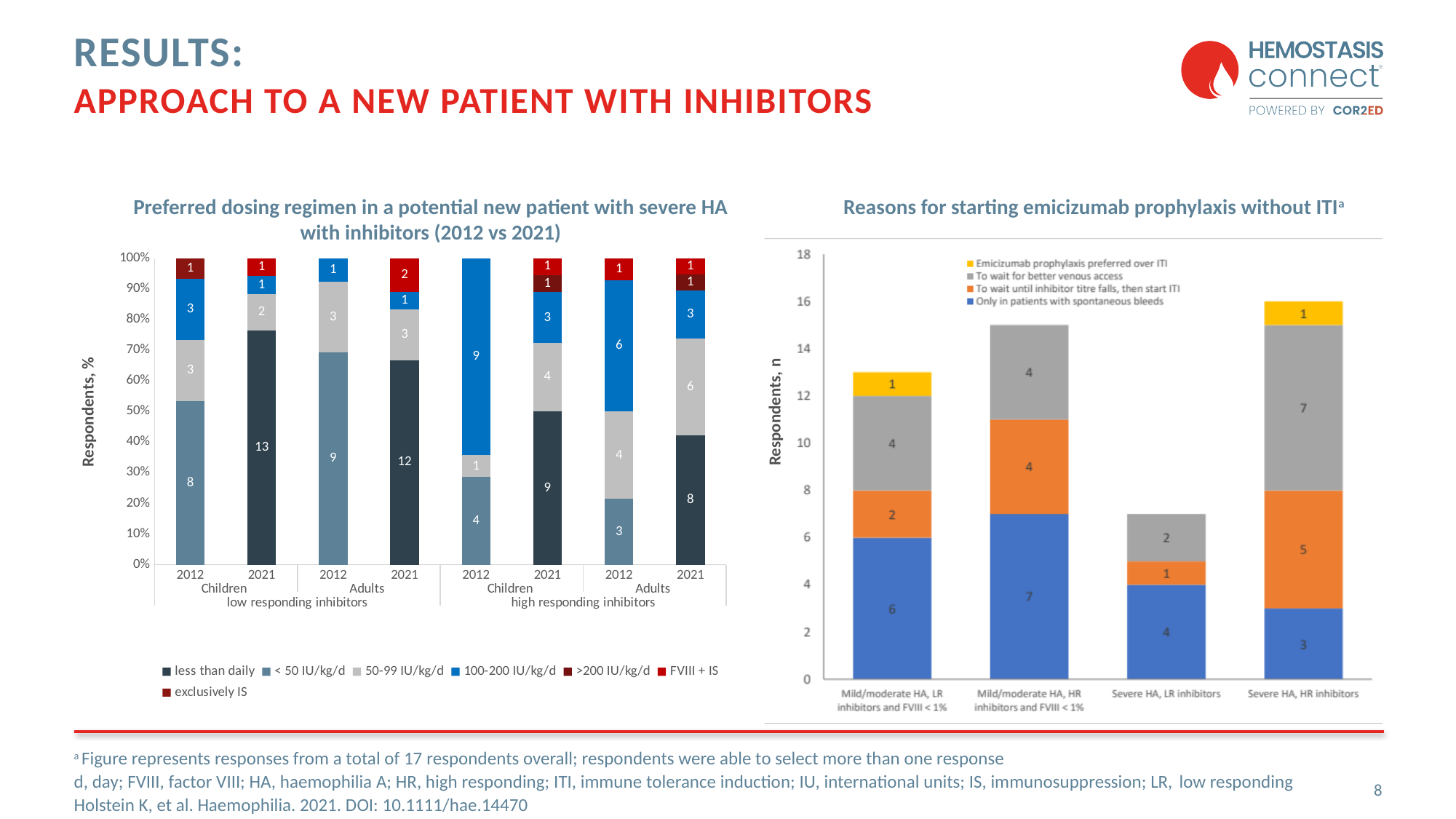
In the chart 'Reasons for starting emicizumab prophylaxis without ITI', how many respondents chose 'To wait for better venous access' for Severe HA, HR inhibitors? 7 In the chart 'Reasons for starting emicizumab prophylaxis without ITI', what is the difference between the 'To wait until inhibitor titre falls, then start ITI' values for Severe HA, HR inhibitors and Severe HA, LR inhibitors? 4 In the chart 'Reasons for starting emicizumab prophylaxis without ITI', which category has the tallest stacked bar? Severe HA, HR inhibitors How many series does the legend of the chart 'Preferred dosing regimen in a potential new patient with severe HA with inhibitors (2012 vs 2021)' list? 7 In the chart 'Reasons for starting emicizumab prophylaxis without ITI', what is the total height of the stacked bar for Severe HA, LR inhibitors? 7 How many bars are plotted in the chart 'Preferred dosing regimen in a potential new patient with severe HA with inhibitors (2012 vs 2021)'? 8 What kind of chart is 'Reasons for starting emicizumab prophylaxis without ITI'? Stacked bar chart How many series does the legend of the chart 'Reasons for starting emicizumab prophylaxis without ITI' list? 4 In the chart 'Reasons for starting emicizumab prophylaxis without ITI', how many respondents chose 'Only in patients with spontaneous bleeds' for Mild/moderate HA, HR inhibitors and FVIII < 1%? 7 In the chart 'Reasons for starting emicizumab prophylaxis without ITI', which category has the shortest stacked bar? Severe HA, LR inhibitors In the chart 'Preferred dosing regimen in a potential new patient with severe HA with inhibitors (2012 vs 2021)', how many respondents chose 'less than daily' for Children with low responding inhibitors in 2021? 13 In the chart 'Preferred dosing regimen in a potential new patient with severe HA with inhibitors (2012 vs 2021)', how many respondents chose '100-200 IU/kg/d' for Children with high responding inhibitors in 2012? 9